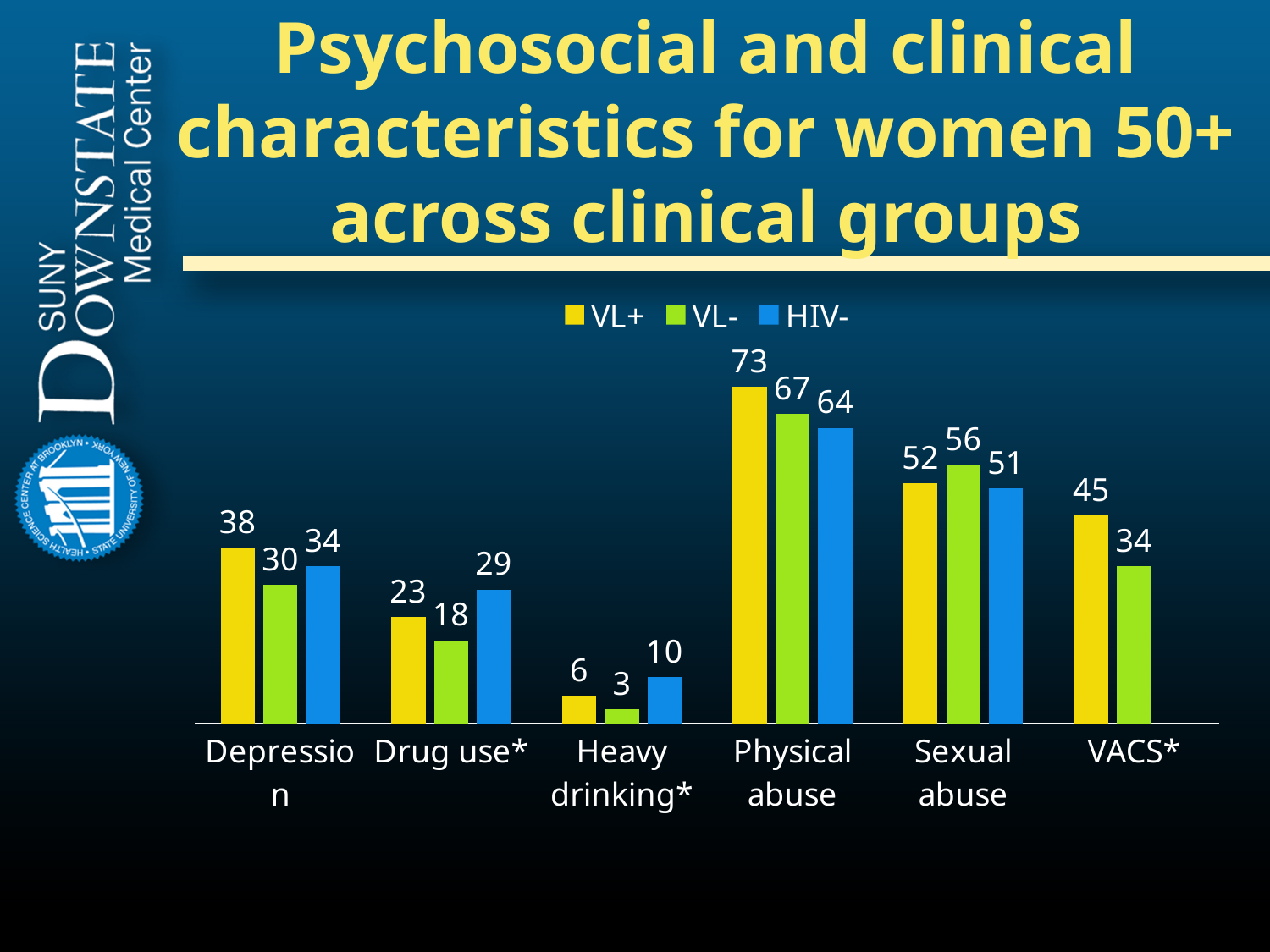
Which series is shown in blue in the legend? HIV- What kind of chart is shown on the slide? Bar chart What is the VL- value for Heavy drinking*? 3 What is the VL+ value for Physical abuse? 73 How many categories are shown on the x axis? 6 Which is larger for Sexual abuse, the VL+ value or the VL- value? VL- What is the VL+ value for VACS*? 45 Which category has the highest VL+ value? Physical abuse How many series does the legend list? 3 What is the HIV- value for Drug use*? 29 What is the difference between the VL+ and VL- values for Depression? 8 Which category has the lowest HIV- value? Heavy drinking*